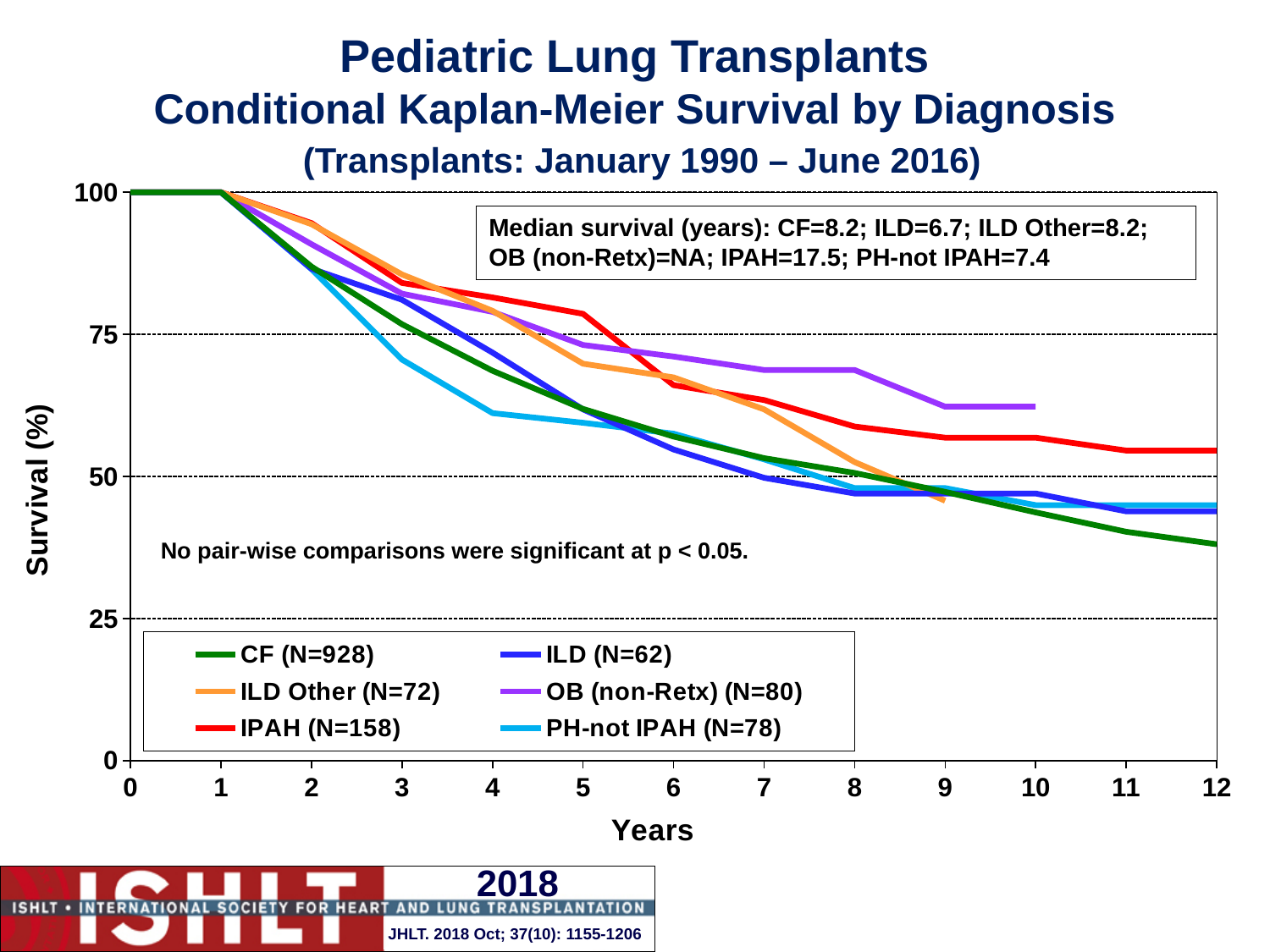
How many series does the legend list? 6 What is the N for the CF group shown in the legend? 928 Do the survival curves rise or fall as years increase? fall According to the text box, what is the median survival for OB (non-Retx)? NA Is the survival value for CF at 12 years greater or less than 50? less What kind of chart is shown on the slide? line chart At 12 years, which has higher survival, IPAH or CF? IPAH Which diagnosis group has the lowest survival at 12 years? CF According to the text box, what is the median survival in years for IPAH? 17.5 Is the survival value for OB (non-Retx) at 10 years greater or less than 50? greater Is the survival value for IPAH at 12 years greater or less than 50? greater According to the text box, what is the median survival in years for ILD? 6.7